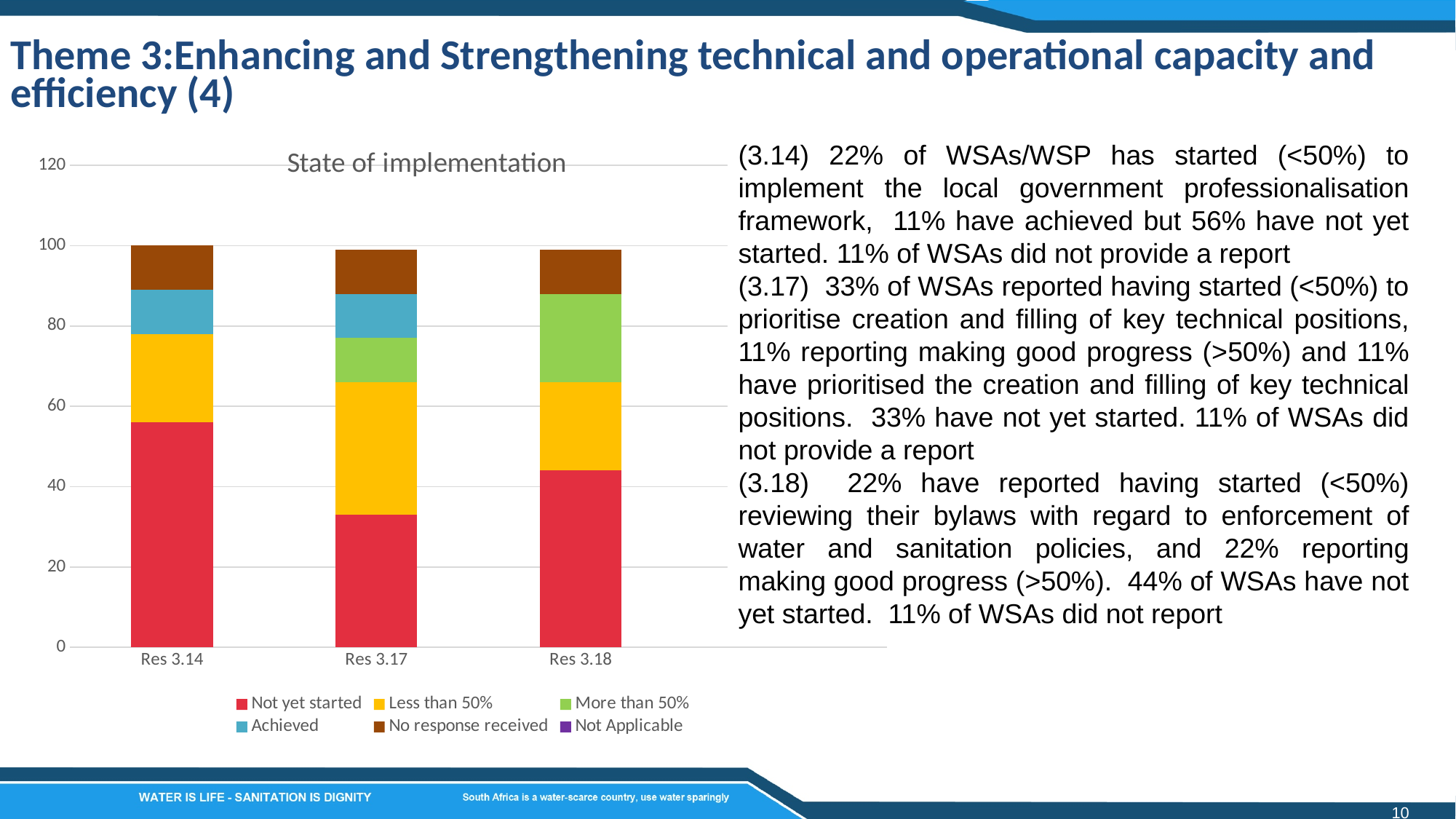
Is the 'Not yet started' value for Res 3.18 greater or less than 60? less How many categories are shown on the x axis of the chart? 3 What is the title of the chart? State of implementation What kind of chart is shown on the slide? Stacked bar chart Which category has a larger 'More than 50%' segment, Res 3.17 or Res 3.18? Res 3.18 Which category has the smallest 'Not yet started' segment? Res 3.17 Is the 'Not yet started' value for Res 3.17 greater or less than 40? less Which category has the largest 'Not yet started' segment? Res 3.14 Is the 'Not yet started' value for Res 3.14 greater or less than 40? greater Which category has no 'Achieved' segment in its bar? Res 3.18 How many series does the chart legend list? 6 What is the total height of the stacked bar for Res 3.14? 100